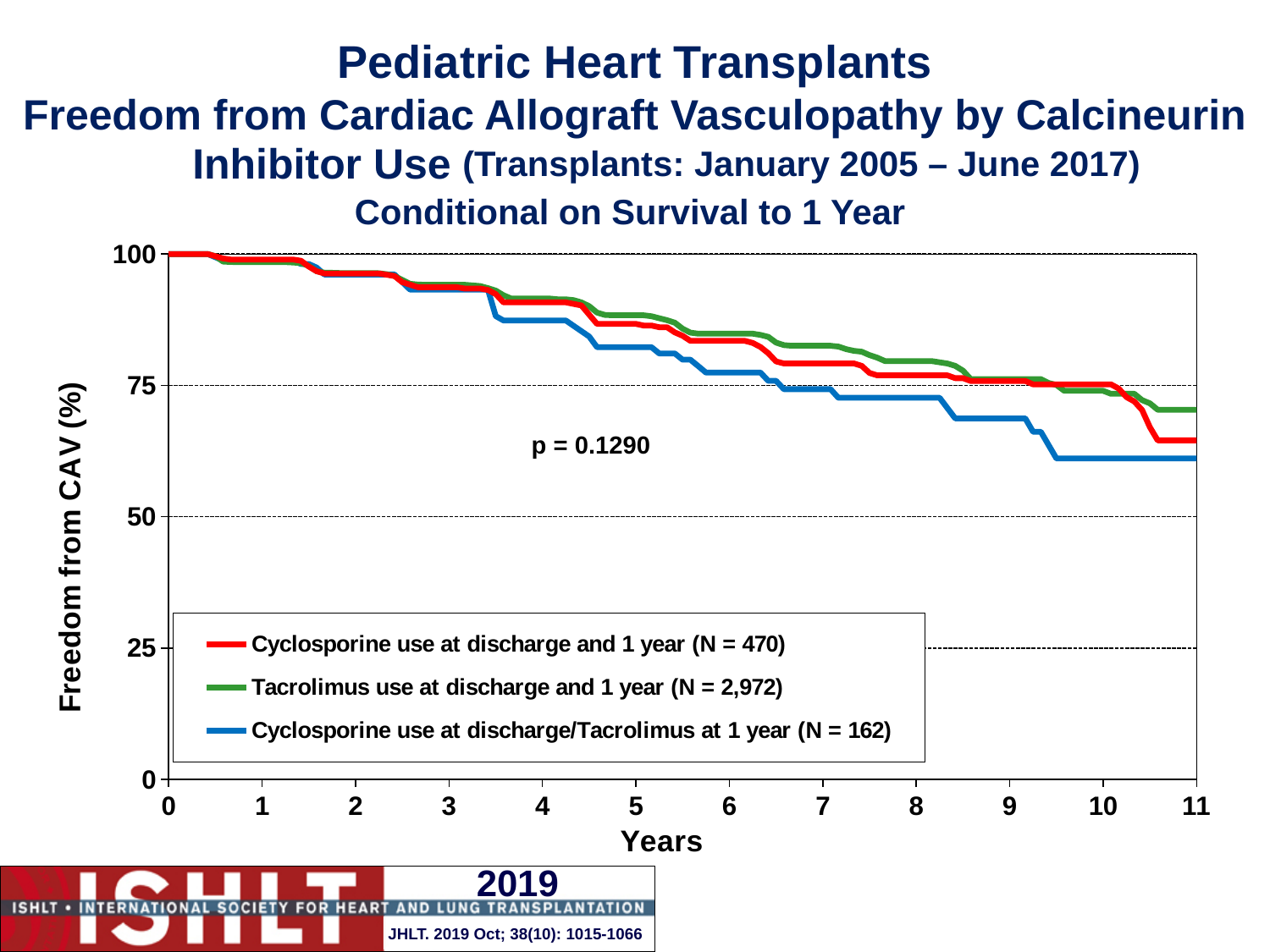
What p-value is printed on the chart? p = 0.1290 How many series does the legend list? 3 Is the value for the Cyclosporine use at discharge and 1 year group at year 3 greater or less than 75? greater Which group has the lowest freedom from CAV at year 11? Cyclosporine use at discharge/Tacrolimus at 1 year Is the value for the Cyclosporine use at discharge/Tacrolimus at 1 year group at year 10 greater or less than 75? less At year 11, which group has the higher freedom from CAV: Tacrolimus use at discharge and 1 year, or Cyclosporine use at discharge and 1 year? Tacrolimus use at discharge and 1 year What kind of chart is shown on the slide? line chart At year 10, which group has the higher freedom from CAV: Cyclosporine use at discharge and 1 year, or Cyclosporine use at discharge/Tacrolimus at 1 year? Cyclosporine use at discharge and 1 year Do the curves rise or fall as the years increase along the x axis? fall Is the value for the Tacrolimus use at discharge and 1 year group at year 11 greater or less than 75? less What is the N for the Tacrolimus use at discharge and 1 year group shown in the legend? N = 2,972 What is the freedom from CAV value for all three groups at year 0? 100